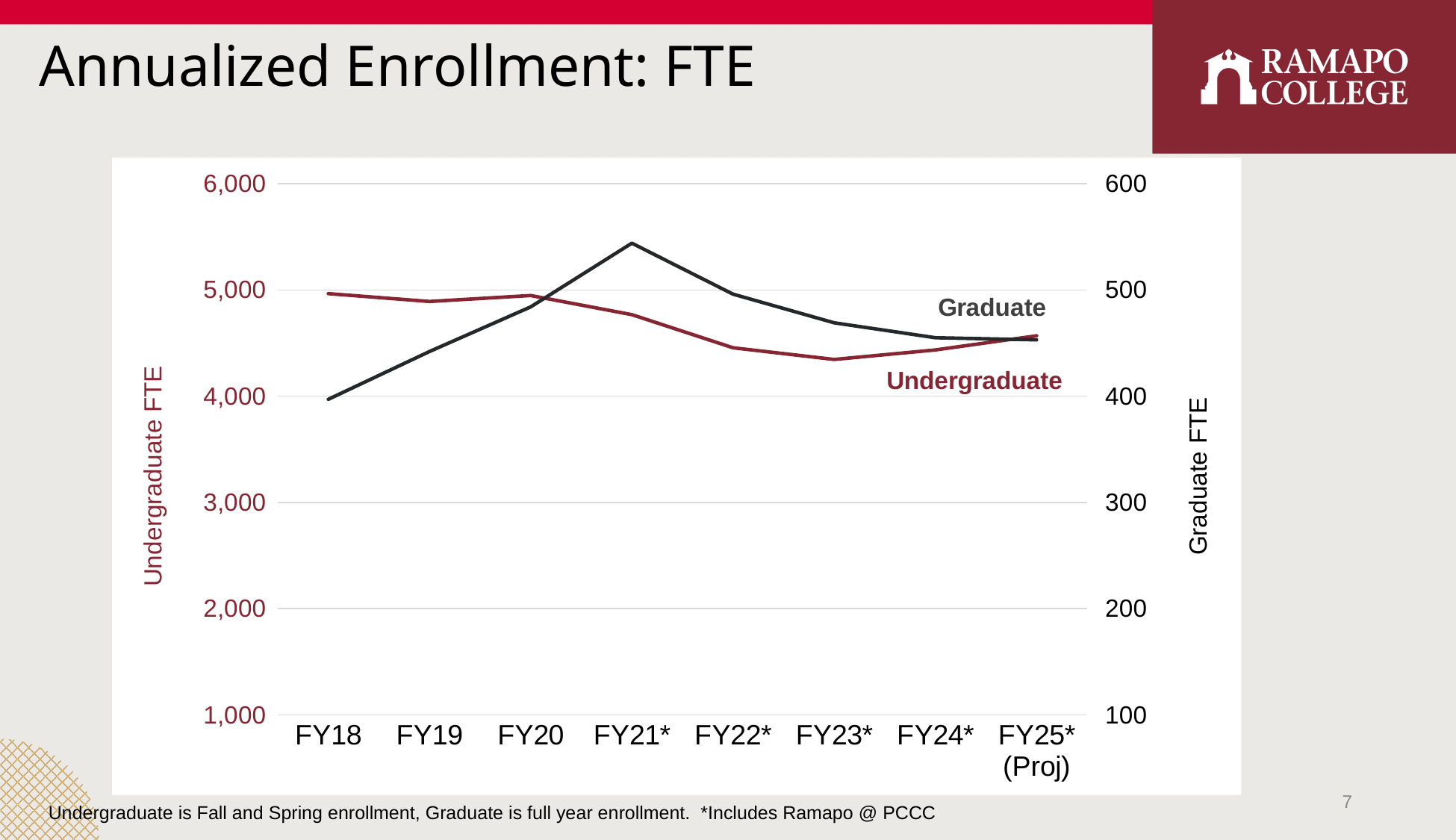
Which is higher for the Graduate series, FY21* or FY22*? FY21* In which fiscal year is the Undergraduate line at its lowest value? FY23* Is the Undergraduate FTE value for FY23* greater or less than 4,000? greater Is the Undergraduate FTE value for FY22* greater or less than 5,000? less Does the Graduate line rise or fall from FY21* to FY24*? Fall How many series are plotted on the chart? 2 What is the title of the right-hand vertical axis? Graduate FTE In which fiscal year is the Graduate line at its lowest value? FY18 What kind of chart is shown on the slide? Line chart In which fiscal year does the Graduate line reach its highest value? FY21* Is the Graduate FTE value for FY21* greater or less than 500? greater How many fiscal years are plotted along the x axis? 8